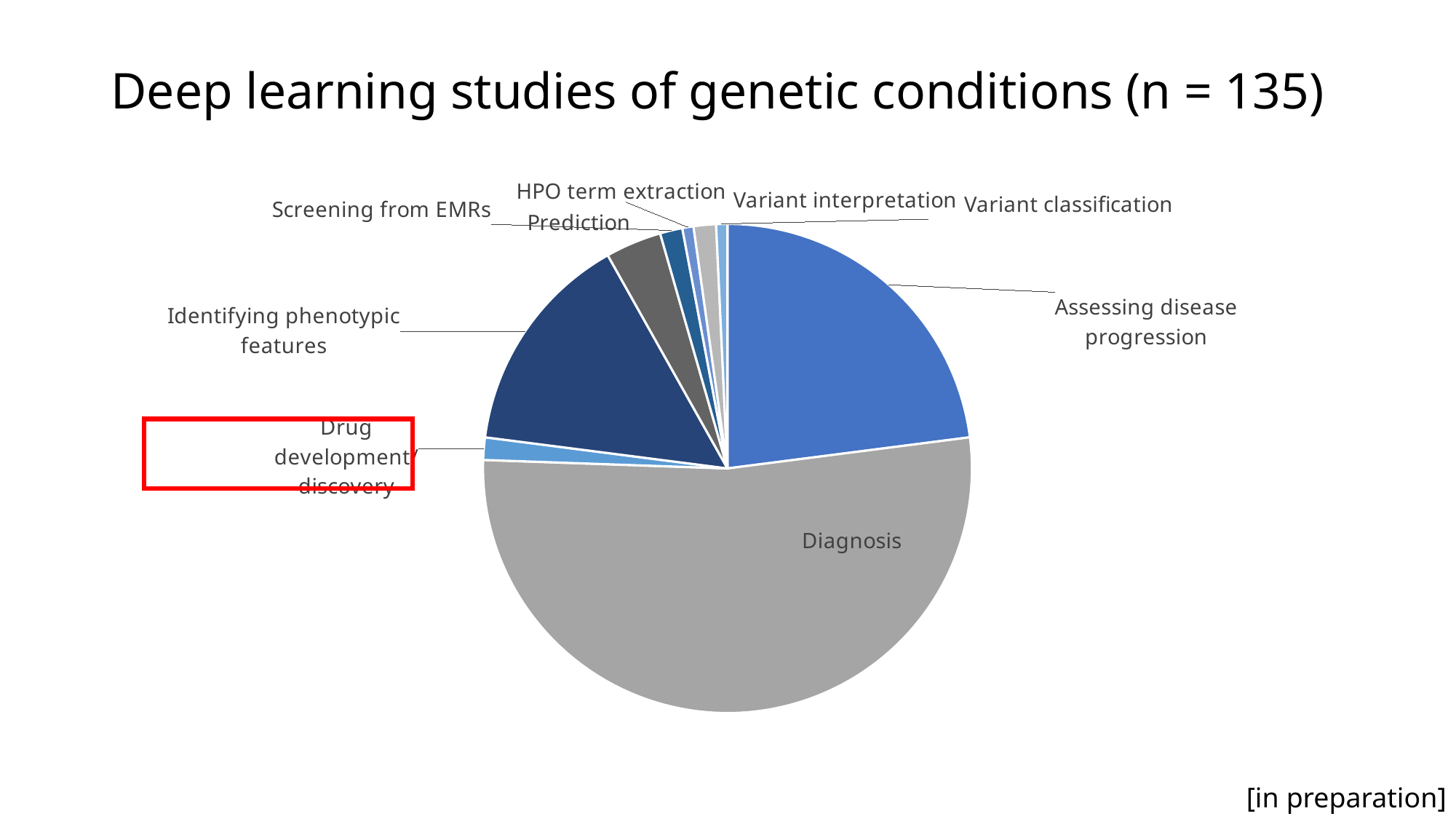
Which slice is larger: Diagnosis or Identifying phenotypic features? Diagnosis How many studies are included in the pie chart, according to the title? 135 Which category has the largest slice of the pie chart? Diagnosis How many slices (categories) does the pie chart have? 9 What kind of chart is shown on the slide? pie chart Which slice is larger: Diagnosis or Assessing disease progression? Diagnosis Which slice is larger: Identifying phenotypic features or Screening from EMRs? Identifying phenotypic features What is the title of the chart on the slide? Deep learning studies of genetic conditions (n = 135)